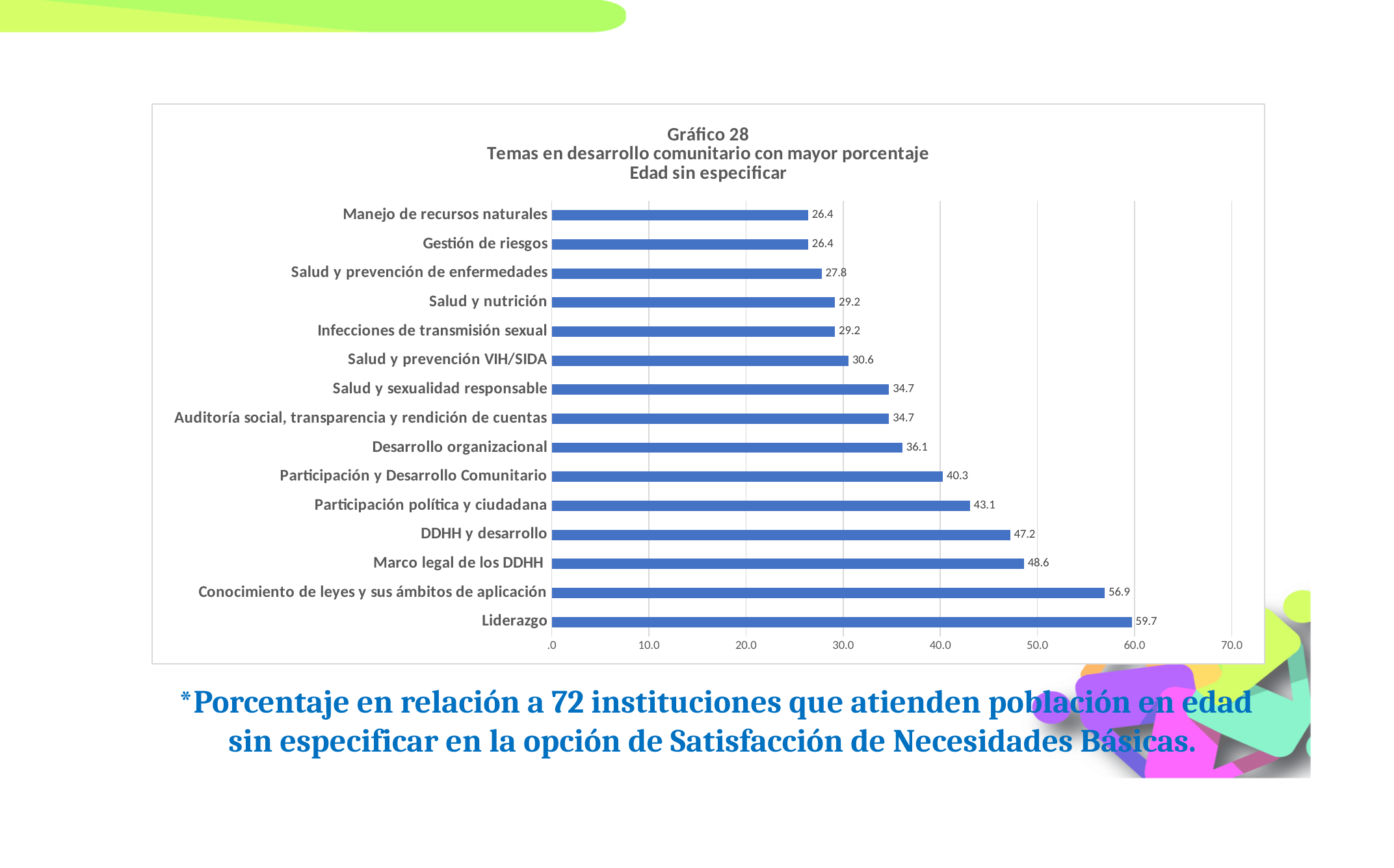
Is the value for Salud y sexualidad responsable greater or less than 30.0? greater What is the value for Salud y prevención VIH/SIDA? 30.6 What is the value for Conocimiento de leyes y sus ámbitos de aplicación? 56.9 Which is larger, the value for Participación política y ciudadana or the value for Participación y Desarrollo Comunitario? Participación política y ciudadana Which category has the highest value? Liderazgo What kind of chart is shown on the slide? bar chart How many categories are shown in the chart? 15 What is the difference between the values for Marco legal de los DDHH and DDHH y desarrollo? 1.4 What is the value for Desarrollo organizacional? 36.1 What is the value for Liderazgo? 59.7 What is the number of the gráfico shown in the chart title? Gráfico 28 What is the difference between the values for Liderazgo and Conocimiento de leyes y sus ámbitos de aplicación? 2.8